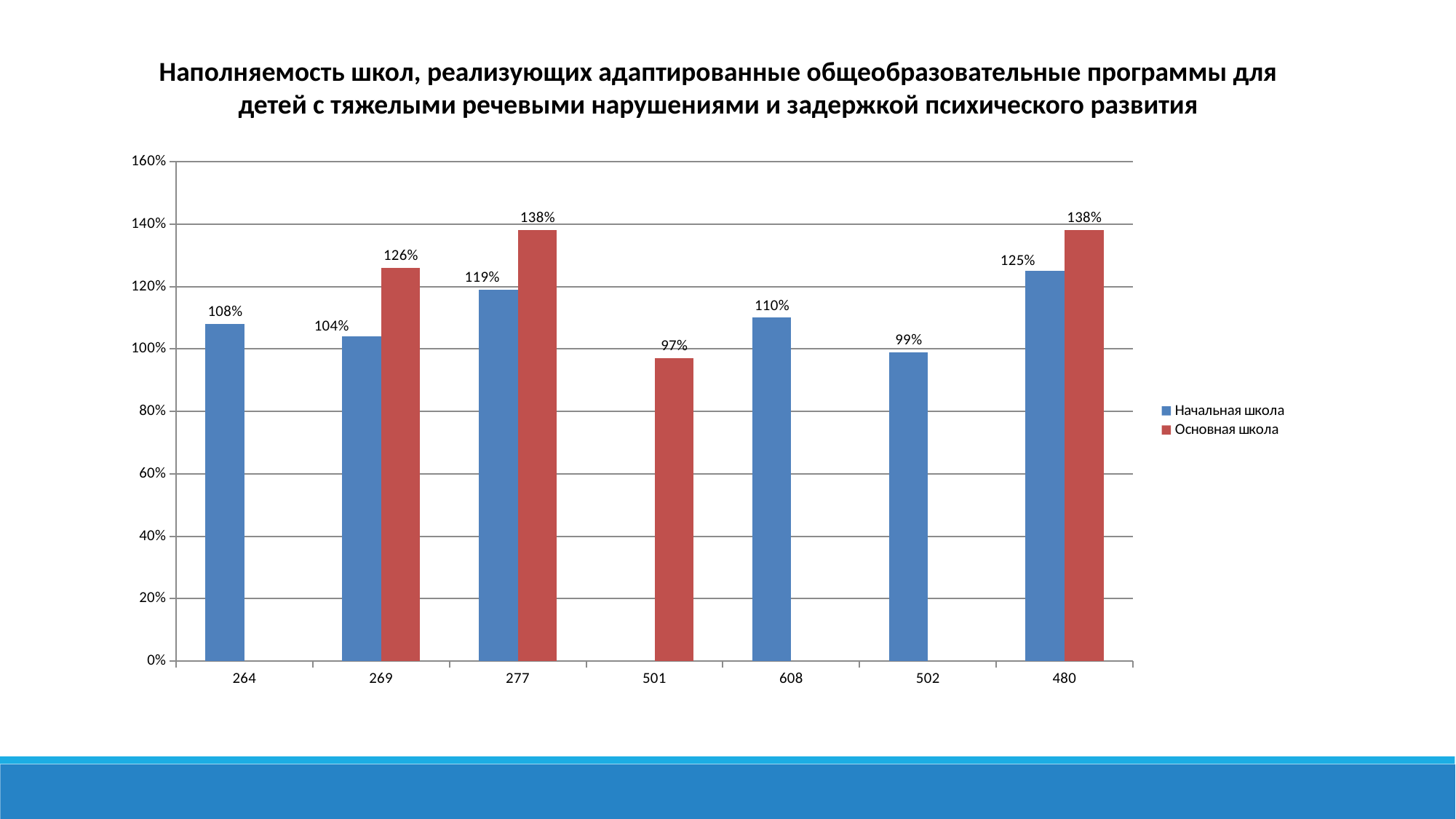
How many schools are shown on the x axis? 7 What is the value for Основная школа at school 269? 126% Which is larger at school 269: Начальная школа or Основная школа? Основная школа Which school has the highest value for Начальная школа? 480 What is the difference between Основная школа and Начальная школа at school 277? 19% How many series does the legend list? 2 Which school has the lowest value for Основная школа? 501 What is the value for Начальная школа at school 277? 119% What kind of chart is shown on the slide? bar chart What is the value for Начальная школа at school 264? 108% Which school has the lowest value for Начальная школа? 502 Is the value for Основная школа at school 501 greater or less than 100%? less